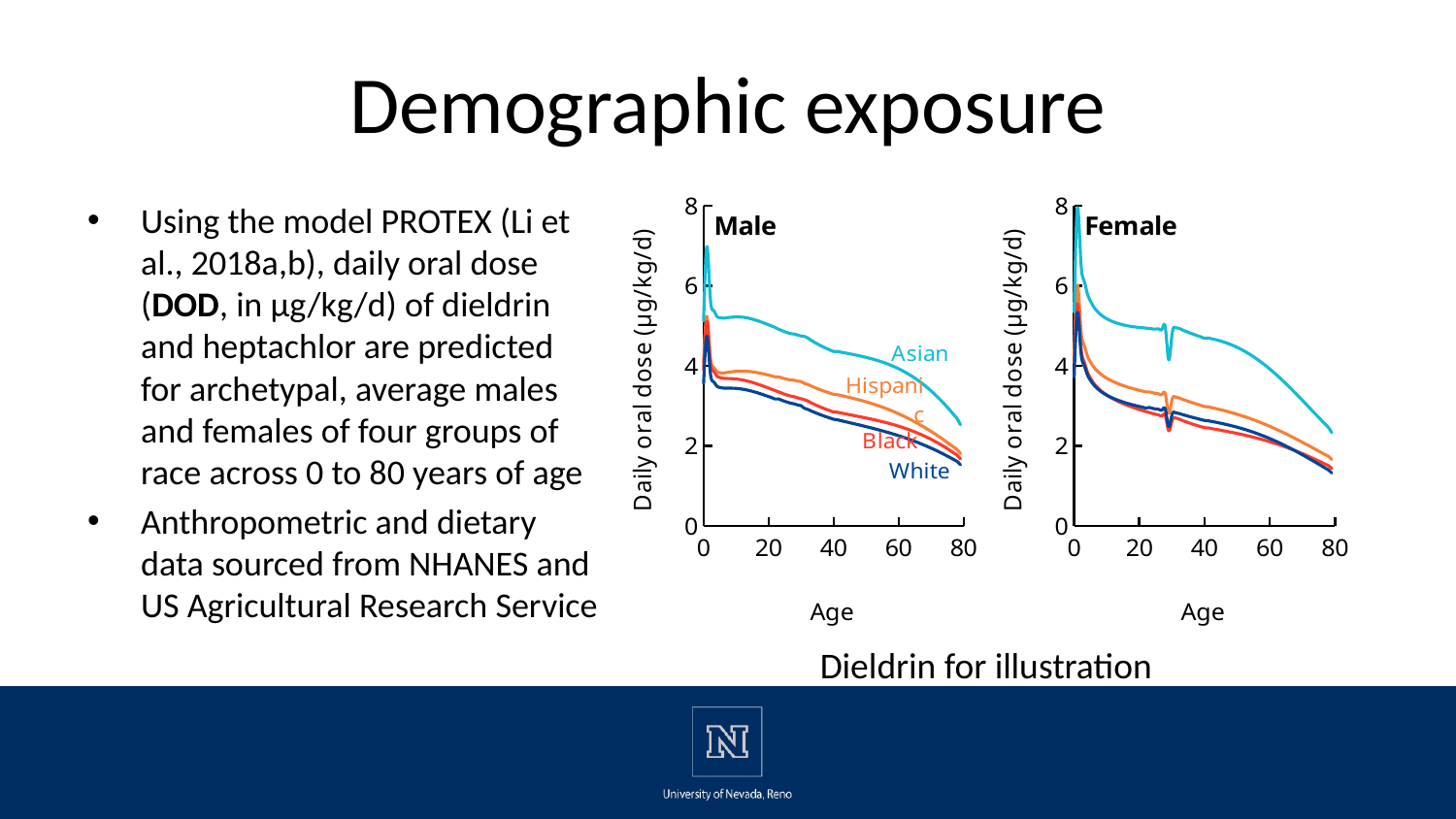
In the Male chart, is the daily oral dose for Asian at age 40 greater or less than 4? Greater In the Male chart, which race group has the highest daily oral dose across ages? Asian In the Female chart, is the daily oral dose for White at age 80 greater or less than 2? Less In the Male chart, do the daily oral dose values generally rise or fall as age increases from 20 to 80? Fall What type of chart is used for the Male and Female panels? Line chart In the Female chart, which race group has the highest daily oral dose across ages? Asian What is the x-axis label of the Female chart? Age In the Male chart, at age 40, which is larger: the daily oral dose for Asian or for White? Asian What is the y-axis label of the Male chart? Daily oral dose (µg/kg/d) In the Female chart, do the daily oral dose values generally rise or fall as age increases from 20 to 80? Fall How many race groups (series) are plotted in the Male chart? 4 In the Male chart, is the daily oral dose for White at age 80 greater or less than 2? Less